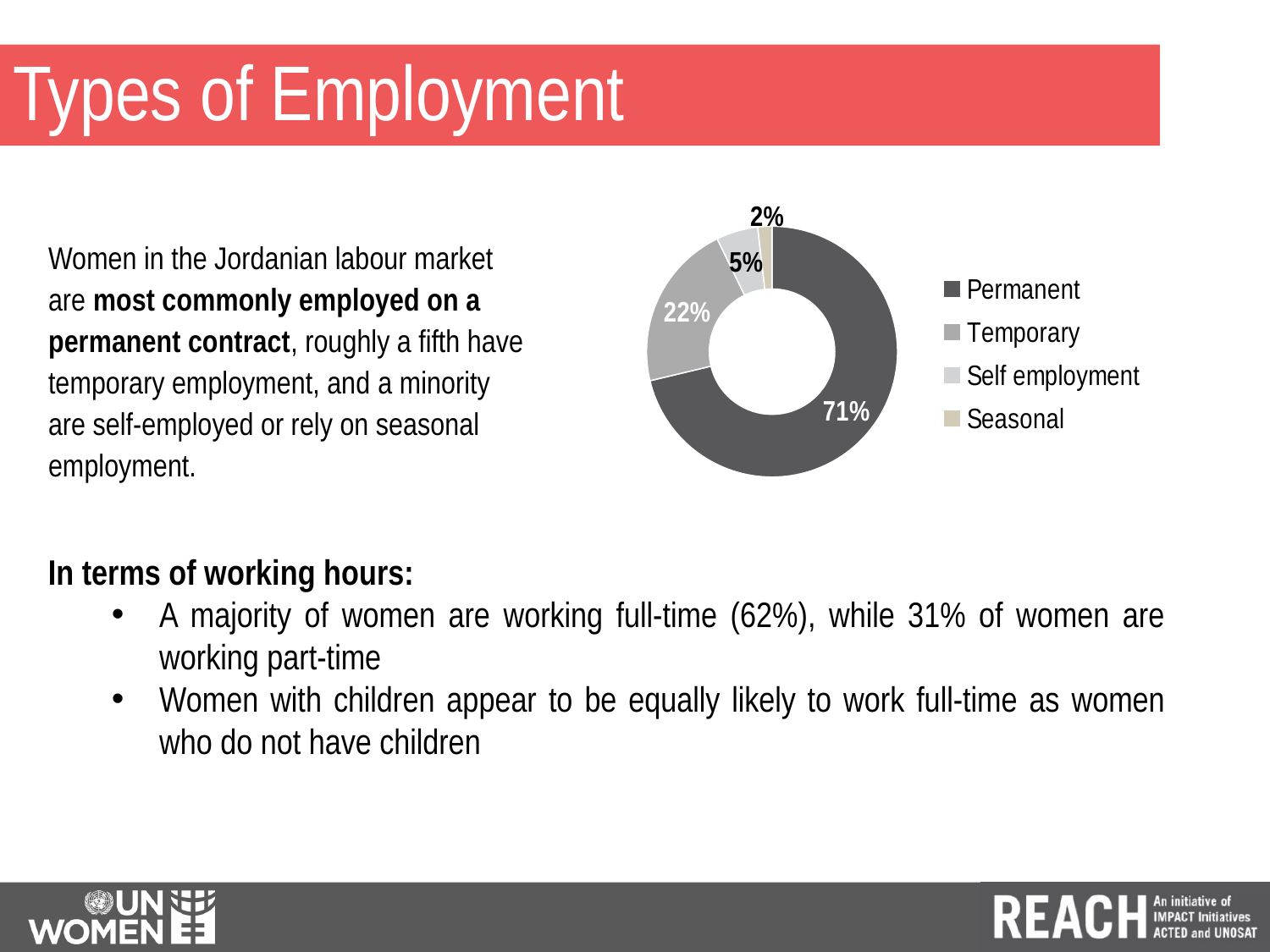
What share of the pie chart is Seasonal employment? 2% What share of the pie chart is Permanent employment? 71% What share of the pie chart is Self employment? 5% Which legend entry is listed first in the chart's legend? Permanent What share of the pie chart is Temporary employment? 22% What is the combined share of Self employment and Seasonal employment? 7% Which is larger, the Temporary share or the Self employment share? Temporary Which employment type has the smallest share in the pie chart? Seasonal How many employment types are shown in the pie chart? 4 Which employment type has the largest share in the pie chart? Permanent What is the difference in percentage points between the Permanent and Temporary shares? 49 What kind of chart is shown on the slide? Doughnut chart